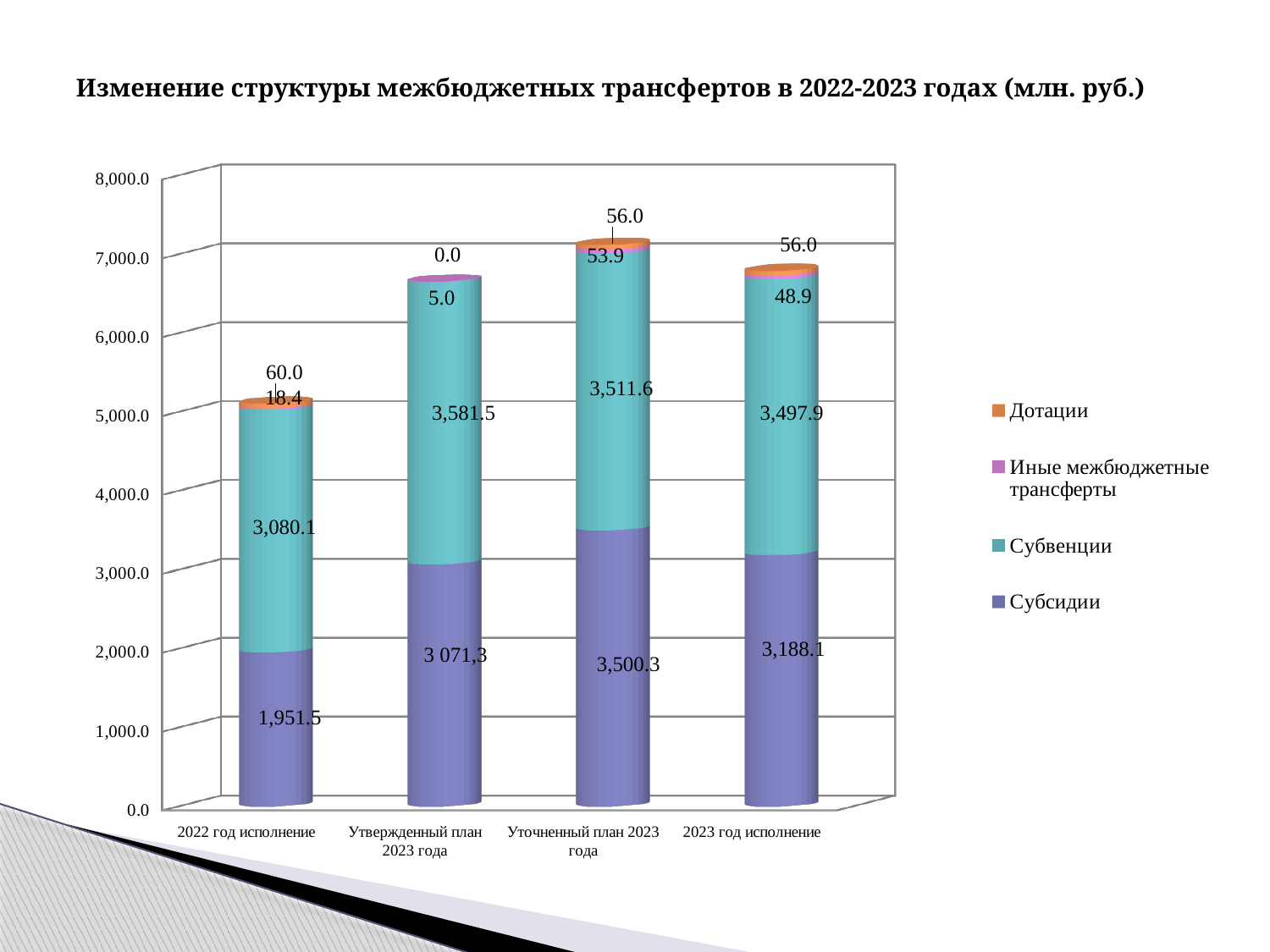
What kind of chart is shown on the slide? Stacked bar chart Which category has the lowest value for Субсидии? 2022 год исполнение What is the difference between the Субвенции values for 2023 год исполнение and 2022 год исполнение? 417.8 How many categories are shown on the x axis? 4 What is the value of Субсидии for 2022 год исполнение? 1,951.5 What is the value of Субвенции for Уточненный план 2023 года? 3,511.6 How many series does the legend list? 4 What is the total of the stacked bar for 2022 год исполнение? 5,110.0 Which category has the highest value for Субвенции? Утвержденный план 2023 года What is the value of Дотации for Утвержденный план 2023 года? 0.0 Which is larger: Субсидии for Уточненный план 2023 года or Субсидии for 2023 год исполнение? Уточненный план 2023 года What is the value of Иные межбюджетные трансферты for 2023 год исполнение? 48.9